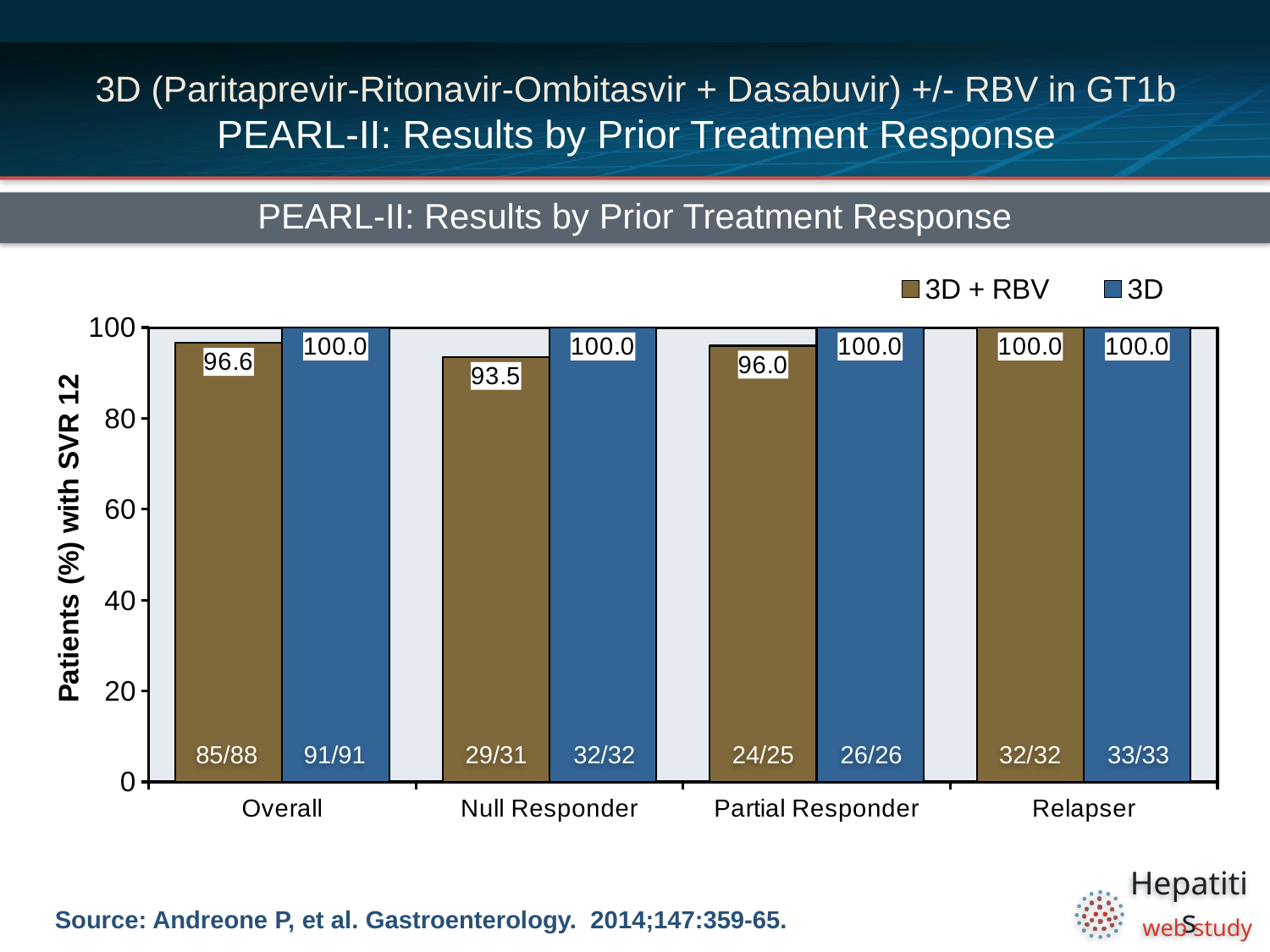
What kind of chart is shown on the slide? Bar chart What is the value for 3D + RBV in the Null Responder category? 93.5 What is the value for 3D + RBV in the Overall category? 96.6 In the Partial Responder category, which series has the larger value, 3D + RBV or 3D? 3D What is the label of the y axis? Patients (%) with SVR 12 How many categories are shown on the x axis? 4 Which category has the lowest value for the 3D + RBV series? Null Responder What is the difference between the 3D and 3D + RBV values in the Null Responder category? 6.5 What is the difference between the 3D + RBV values for Overall and Partial Responder? 0.6 How many series does the legend list? 2 What is the value for 3D + RBV in the Relapser category? 100.0 What is the value for 3D in the Partial Responder category? 100.0